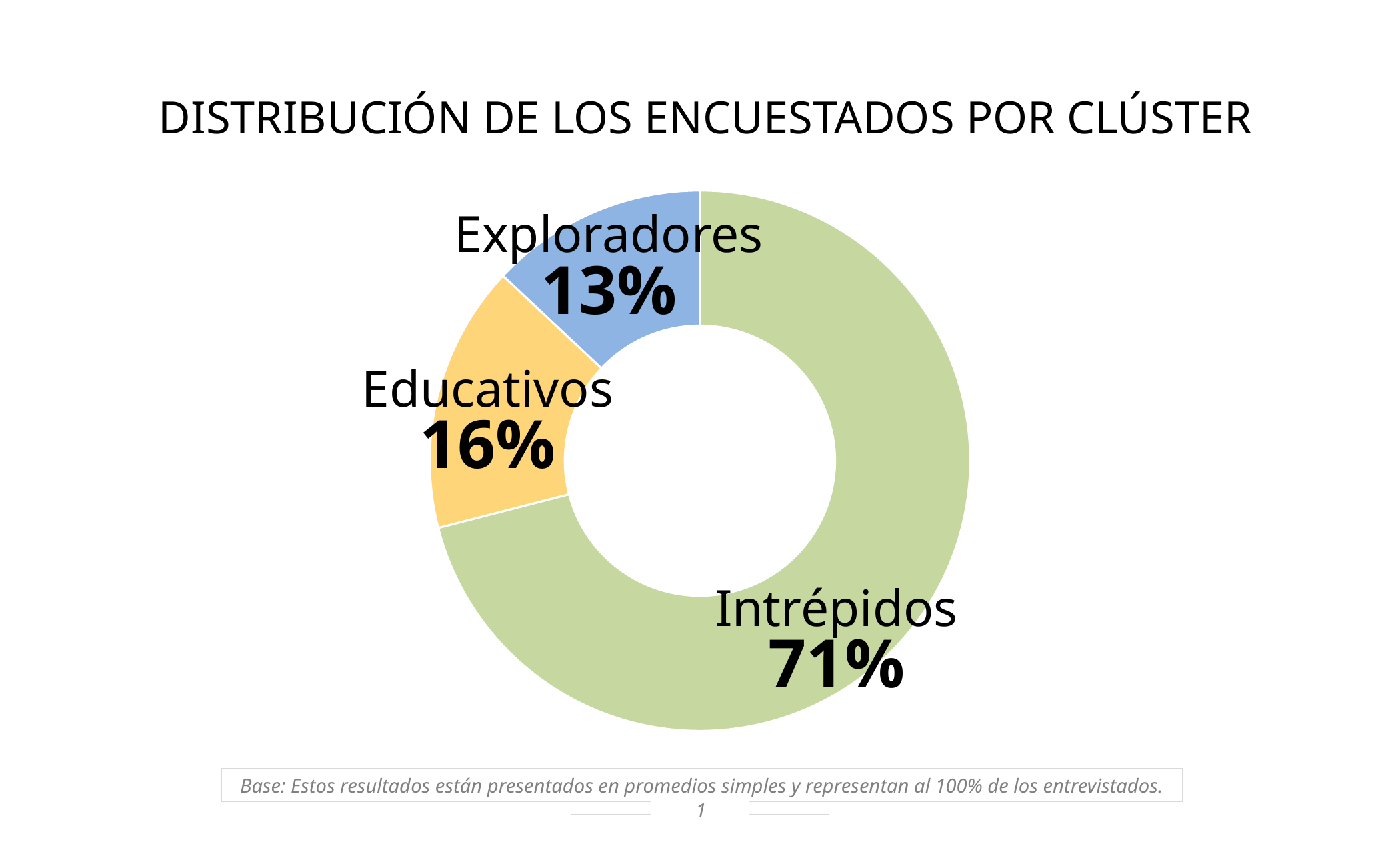
What is the title of the chart? DISTRIBUCIÓN DE LOS ENCUESTADOS POR CLÚSTER Which cluster has the smallest share of respondents? Exploradores What is the difference in percentage points between the Educativos and Exploradores shares? 3 What colour is the Educativos segment? Yellow Which cluster has a larger share, Educativos or Exploradores? Educativos What kind of chart is shown on the slide? Doughnut (pie) chart Which cluster has the largest share of respondents? Intrépidos What is the difference in percentage points between the Intrépidos and Educativos shares? 55 What percentage of respondents are in the Exploradores cluster? 13% What percentage of respondents are in the Intrépidos cluster? 71% How many clusters are shown in the chart? 3 What percentage of respondents are in the Educativos cluster? 16%